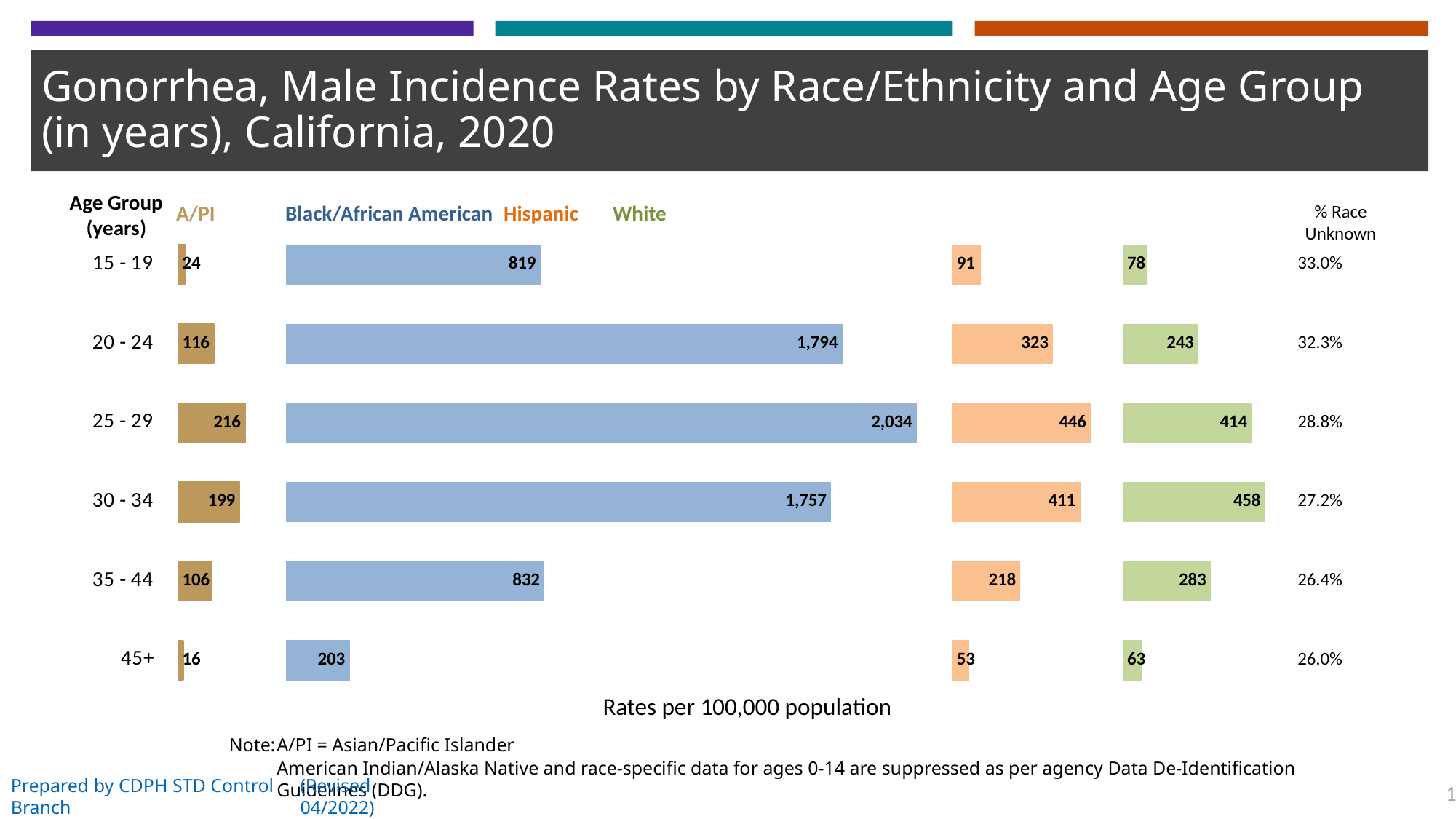
What is the % Race Unknown for the 15 - 19 age group? 33.0% How many race/ethnicity series does the chart show? 4 What kind of chart is shown on the slide? Bar chart What is the gonorrhea incidence rate for Black/African American males aged 25 - 29? 2,034 Which age group has the lowest incidence rate among A/PI males? 45+ What is the incidence rate for A/PI males aged 20 - 24? 116 How many age groups are shown in the chart? 6 What is the difference between the Hispanic and White rates for ages 25 - 29? 32 For ages 30 - 34, which is larger: the Hispanic rate or the White rate? White What is the incidence rate for White males aged 30 - 34? 458 What is the difference between the Black/African American rates for ages 20 - 24 and 30 - 34? 37 Which age group has the highest incidence rate among Hispanic males? 25 - 29